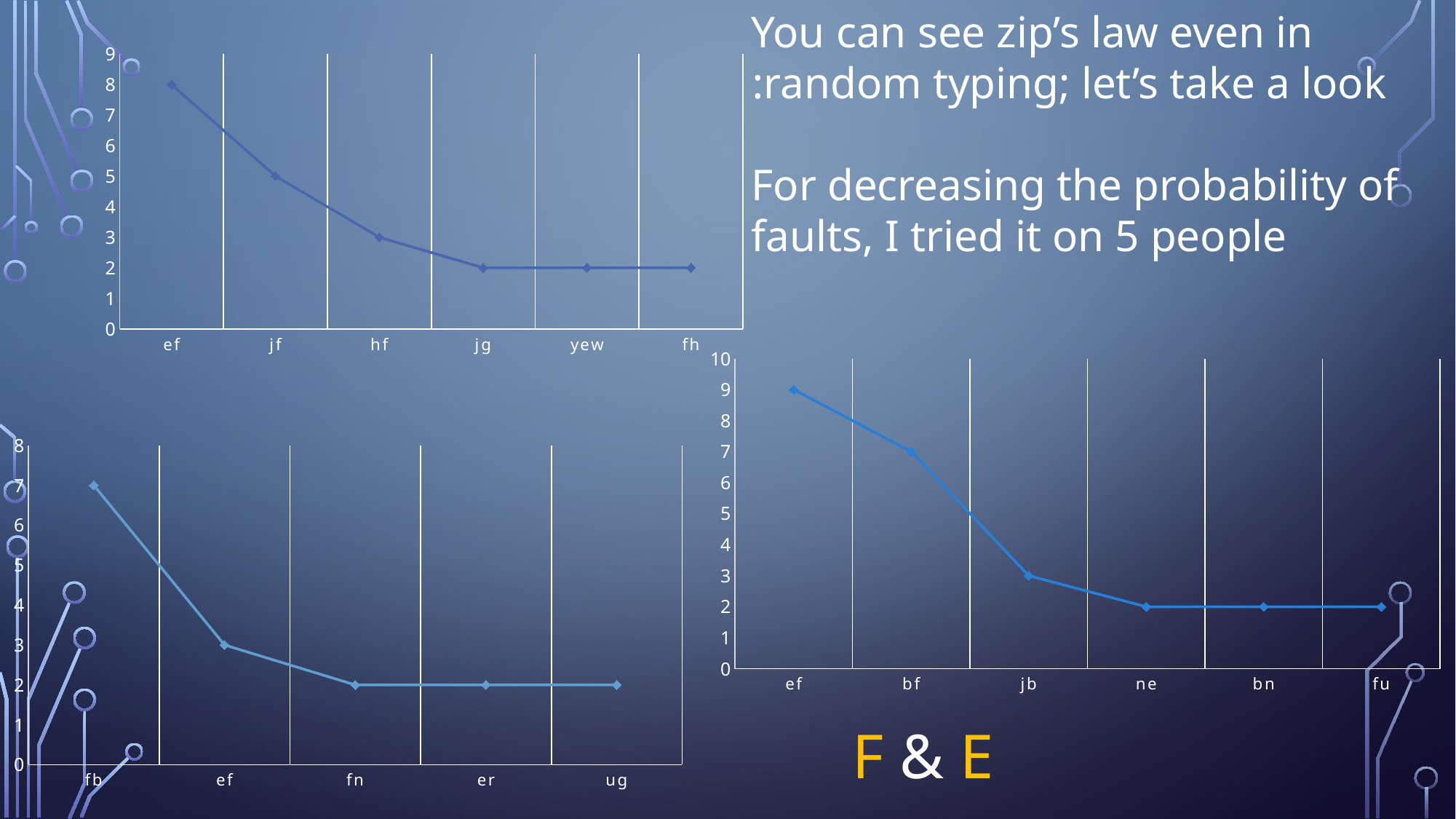
What kind of chart is the right-hand chart? line chart In the top-left chart, how many categories are shown on the x axis? 6 In the bottom-left chart, do the values rise or fall from fb to fn? fall In the right-hand chart, which is larger, the value for jb or the value for ne? jb In the right-hand chart, what is the value for bf? 7 In the top-left chart, what is the value for ef? 8 In the top-left chart, which category has the highest value? ef In the top-left chart, what is the value for hf? 3 In the bottom-left chart, which category has the highest value? fb In the top-left chart, what is the difference between the values for ef and jf? 3 In the bottom-left chart, how many categories are shown on the x axis? 5 In the bottom-left chart, what is the value for fb? 7